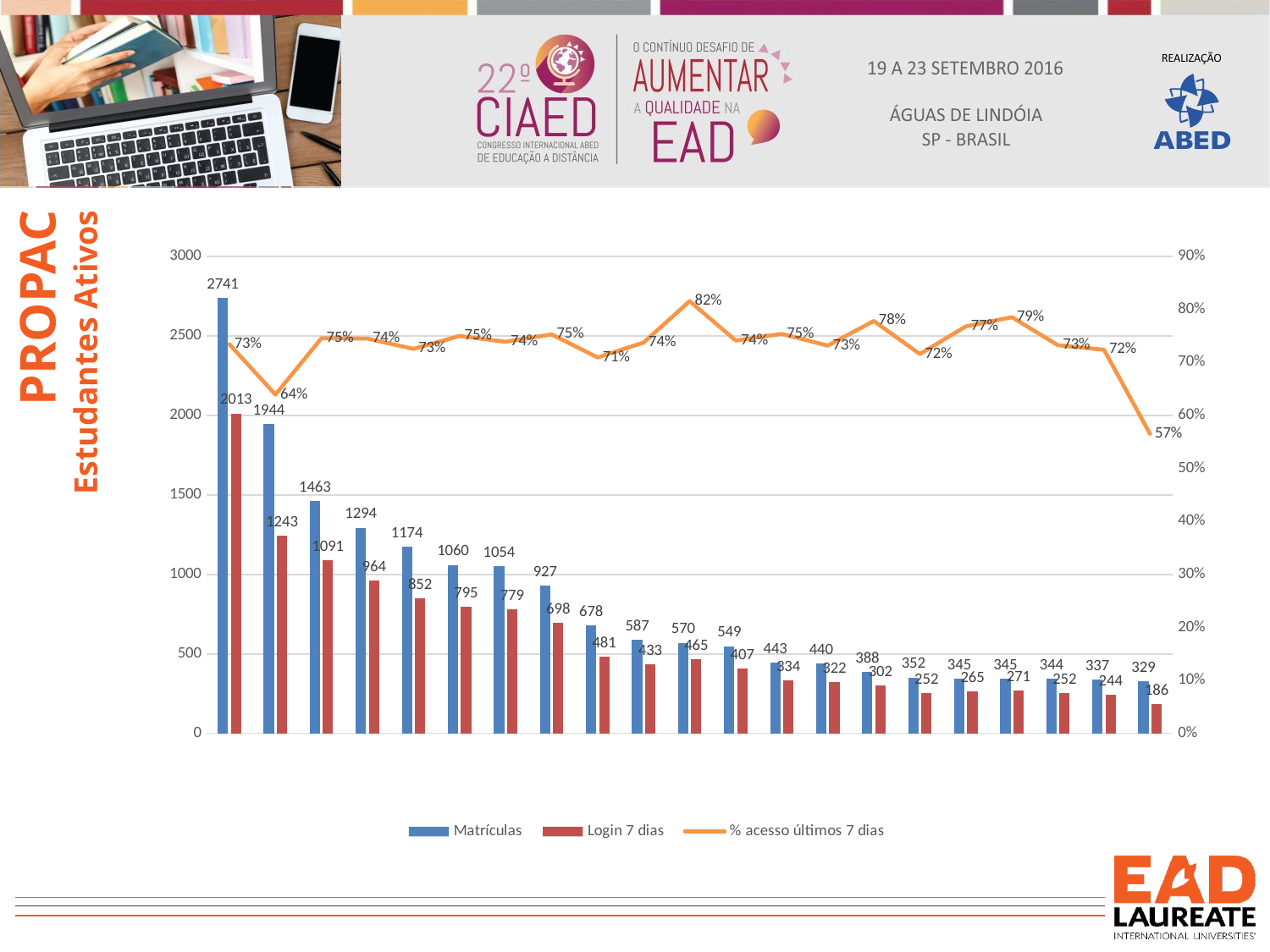
How many series does the legend list? 3 What is the lowest value on the '% acesso últimos 7 dias' line? 57% What is the highest Matrículas value shown in the chart? 2741 Do the Matrículas values generally rise or fall from left to right along the x axis? Fall What is the '% acesso últimos 7 dias' value for the last (rightmost) category? 57% What is the lowest Login 7 dias value shown in the chart? 186 What is the difference between the Matrículas value and the Login 7 dias value for the first (leftmost) category? 728 What is the maximum value shown on the left vertical axis? 3000 What is the highest value on the '% acesso últimos 7 dias' line? 82% What kind of chart is shown on the slide? Combined bar and line chart How many pairs of bars (categories) are plotted in the chart? 21 Which series is shown in orange in the chart? % acesso últimos 7 dias